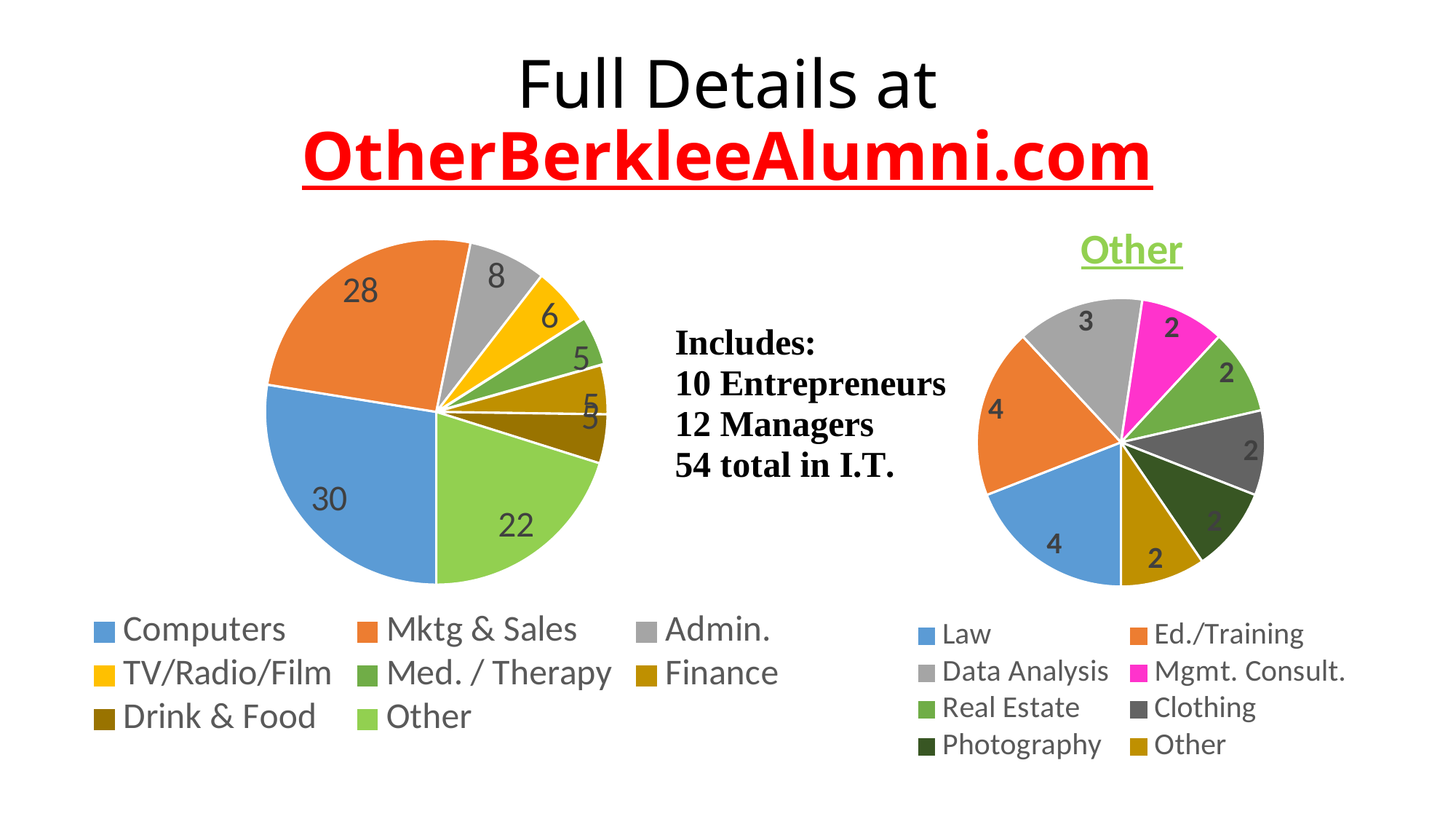
In the left pie chart, what is the value for Computers? 30 In the left pie chart, which is larger, TV/Radio/Film or Admin.? Admin. How many categories does the left pie chart's legend list? 8 In the chart titled 'Other', what is the difference between the values for Ed./Training and Clothing? 2 In the left pie chart, what is the value for Mktg & Sales? 28 In the chart titled 'Other', what is the value for Law? 4 In the left pie chart, what is the difference between the values for Computers and Other? 8 What kind of chart is the chart titled 'Other'? Pie chart In the chart titled 'Other', what is the value for Data Analysis? 3 In the chart titled 'Other', which colour represents Mgmt. Consult.? Magenta (pink) In the left pie chart, what is the value for Admin.? 8 In the left pie chart, which category has the highest value? Computers